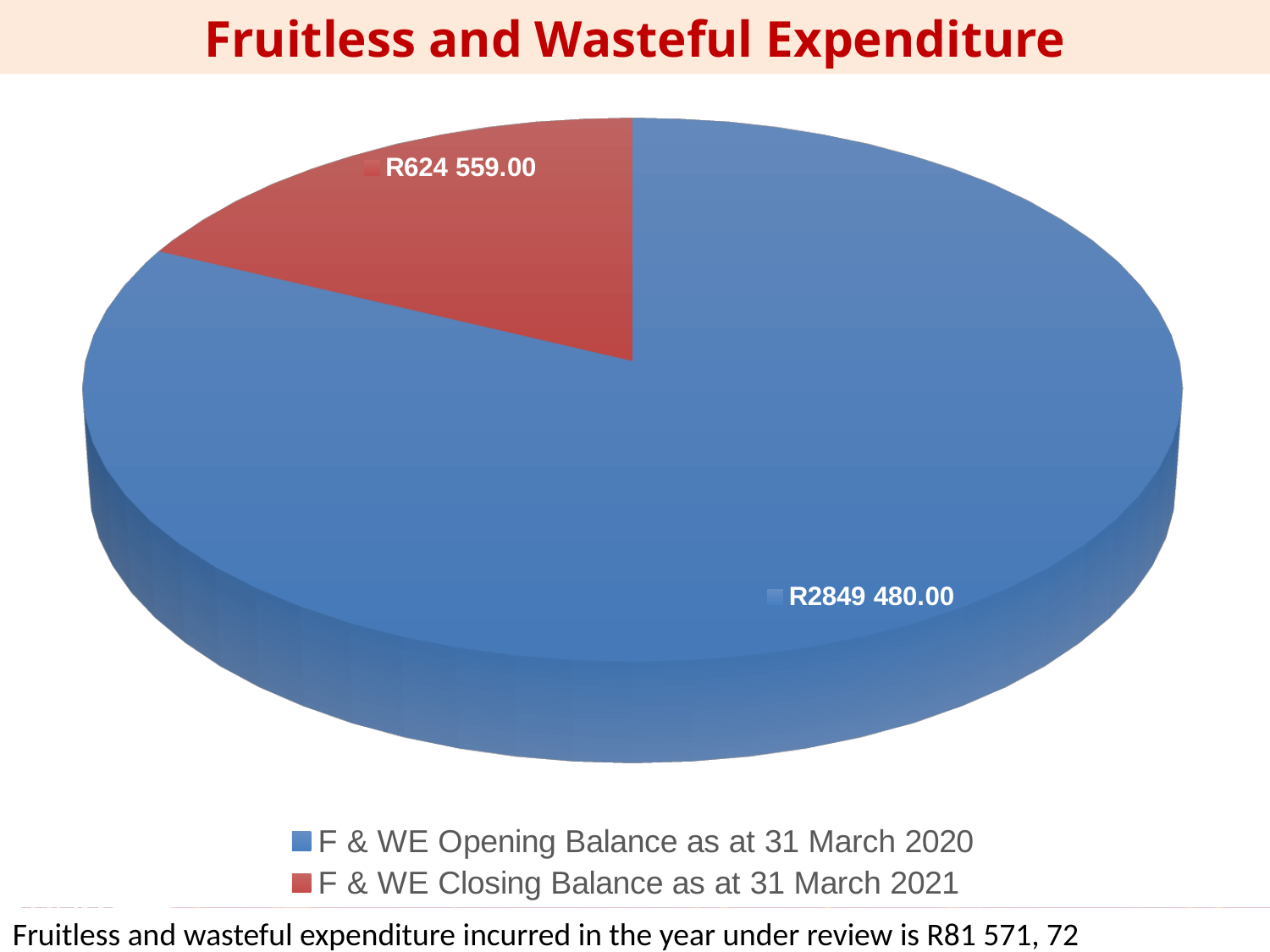
What colour is the slice for F & WE Closing Balance as at 31 March 2021? Red How many entries does the legend list? 2 How many slices does the pie chart have? 2 What is the value for F & WE Opening Balance as at 31 March 2020? R2849 480.00 What is the value for F & WE Closing Balance as at 31 March 2021? R624 559.00 What is the title of the slide containing the chart? Fruitless and Wasteful Expenditure What is the difference between the F & WE Opening Balance as at 31 March 2020 and the F & WE Closing Balance as at 31 March 2021? R2 224 921.00 Which category has the largest slice of the pie? F & WE Opening Balance as at 31 March 2020 Which is larger: the F & WE Opening Balance as at 31 March 2020 or the F & WE Closing Balance as at 31 March 2021? F & WE Opening Balance as at 31 March 2020 What type of chart is shown on the slide? Pie chart What is the total of the two values shown in the pie chart? R3 474 039.00 Which category has the smallest slice of the pie? F & WE Closing Balance as at 31 March 2021